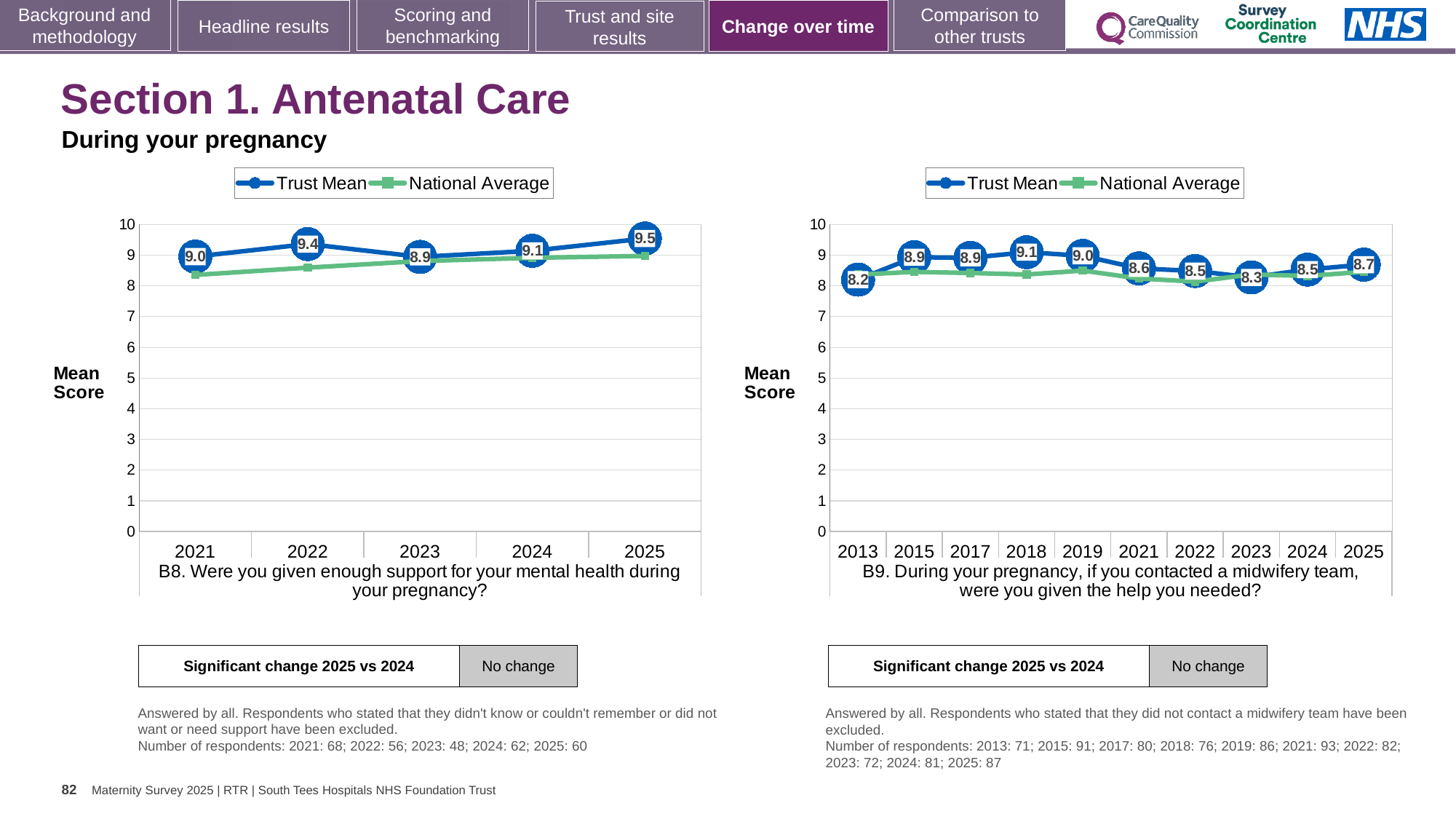
In the right chart (B9), how many years are shown on the x axis? 10 In the left chart (B8), which year has the highest Trust Mean? 2025 In the right chart (B9), which year has the lowest Trust Mean? 2013 How many series does the legend of the right chart (B9) list? 2 In the left chart (B8), what is the Trust Mean for 2025? 9.5 In the right chart (B9), which year has the highest Trust Mean? 2018 In the left chart (B8), is the National Average for 2021 greater or less than 9? less In the right chart (B9), what is the Trust Mean for 2013? 8.2 In the left chart (B8), what is the difference between the Trust Mean in 2025 and in 2021? 0.5 In the left chart (B8), how many years are shown on the x axis? 5 In the left chart (B8), what is the Trust Mean for 2023? 8.9 In the right chart (B9), is the Trust Mean for 2018 larger or smaller than the Trust Mean for 2023? larger